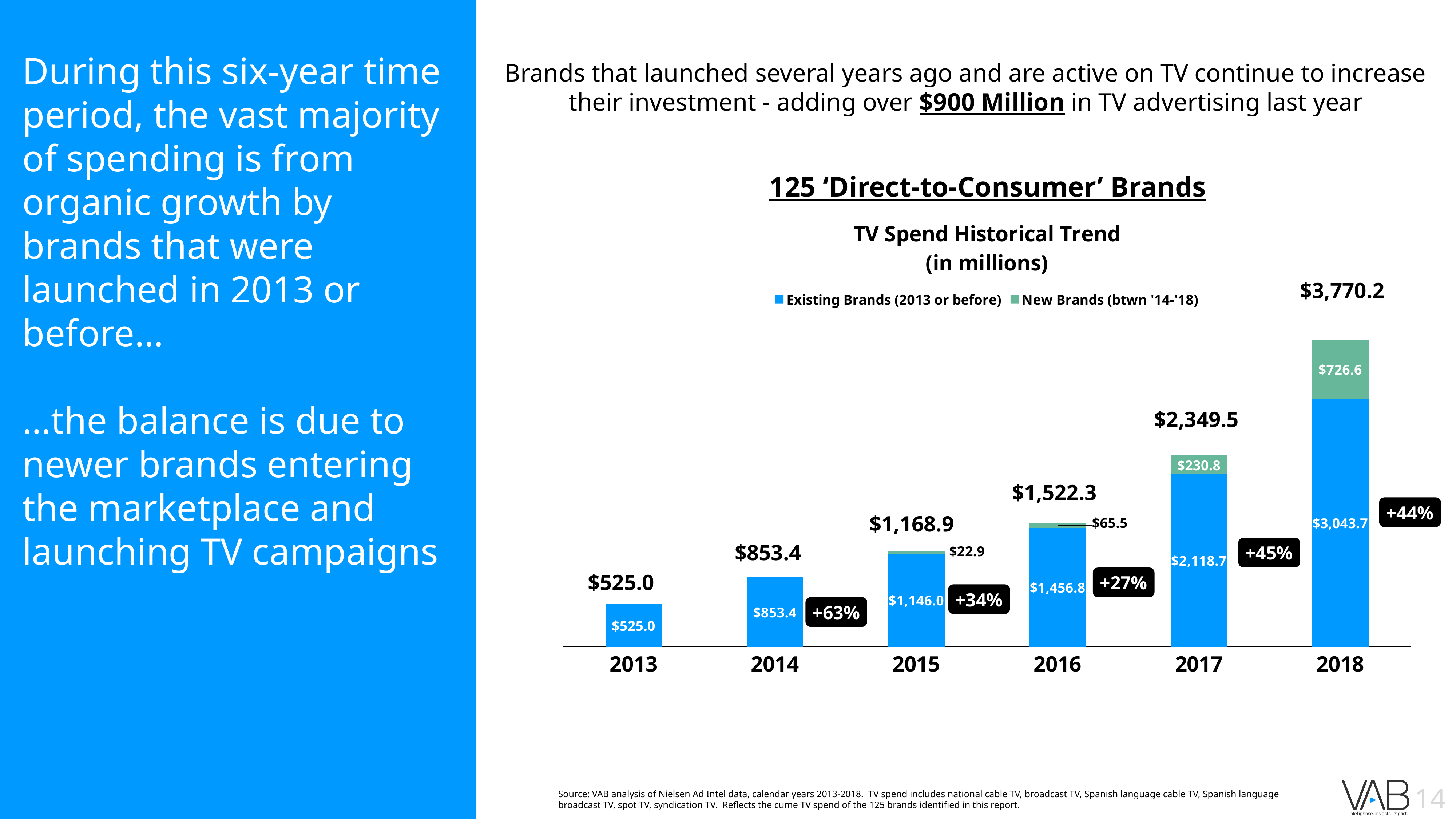
What is the value for Existing Brands (2013 or before) in 2017? $2,118.7 What is the difference between the Existing Brands values for 2018 and 2017? $925.0 What is the value for New Brands (btwn '14-'18) in 2018? $726.6 Do the total TV spend values rise or fall from 2013 to 2018? Rise Which year has the highest total TV spend? 2018 How many series does the legend list? 2 Which year has the lowest total TV spend? 2013 How many years are shown on the x axis? 6 What is the total TV spend shown above the stacked bar for 2016? $1,522.3 What is the value for New Brands (btwn '14-'18) in 2015? $22.9 Which is larger: the New Brands value in 2017 or the New Brands value in 2016? 2017 What kind of chart is shown? Stacked bar chart